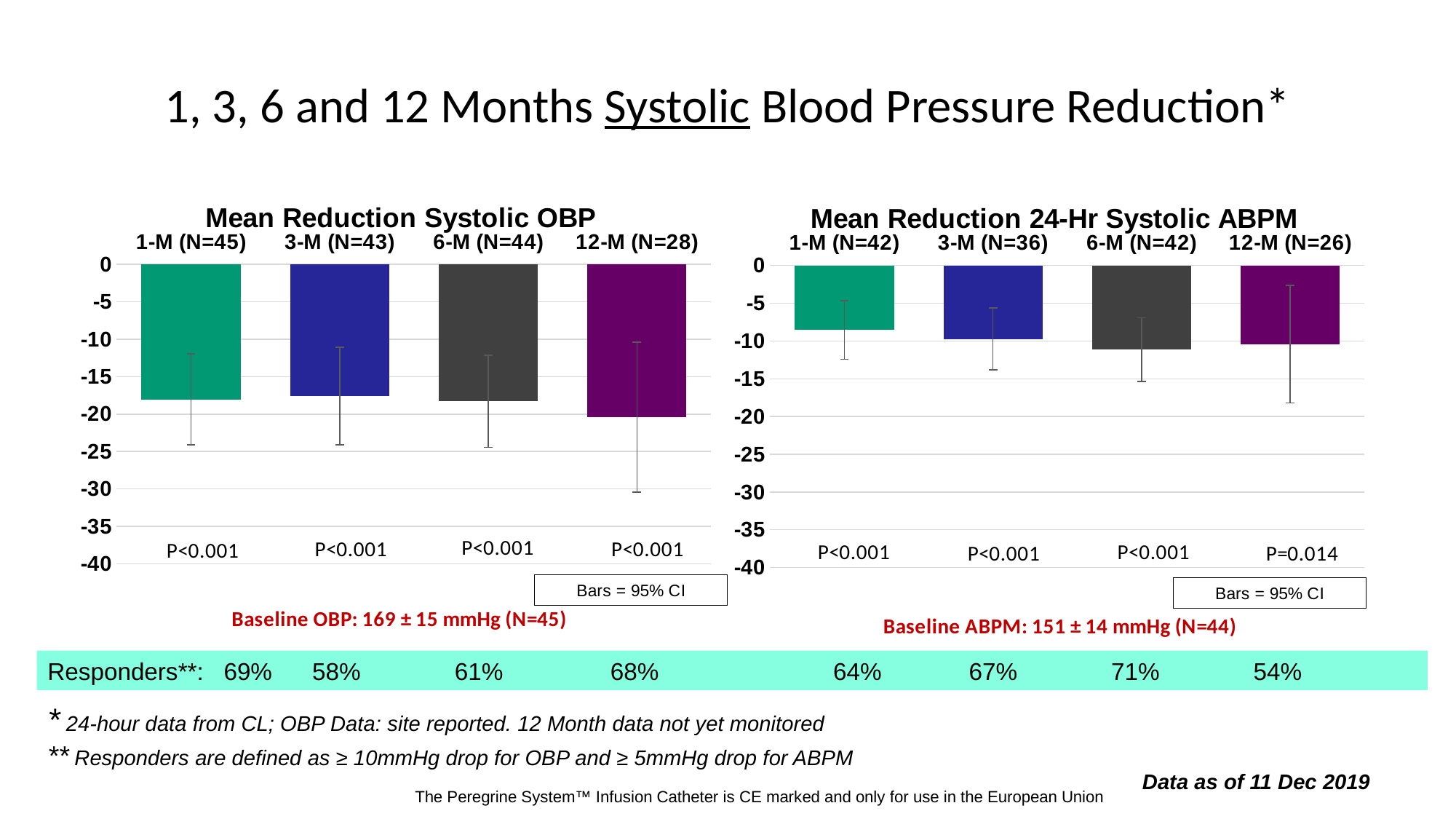
In the Mean Reduction 24-Hr Systolic ABPM chart, which bar shows a larger reduction: 1-M (N=42) or 6-M (N=42)? 6-M (N=42) What kind of chart is the Mean Reduction Systolic OBP chart? bar chart In the Mean Reduction 24-Hr Systolic ABPM chart, what P-value is shown for 12-M (N=26)? P=0.014 What is the title of the chart on the right side of the slide? Mean Reduction 24-Hr Systolic ABPM In the Mean Reduction Systolic OBP chart, which time point shows the largest reduction? 12-M (N=28) How many bars are shown in the Mean Reduction 24-Hr Systolic ABPM chart? 4 In the Mean Reduction 24-Hr Systolic ABPM chart, which time point shows the smallest reduction? 1-M (N=42) In the Mean Reduction 24-Hr Systolic ABPM chart, is the value for 1-M (N=42) greater or less than -10? greater What is the N shown for the 3-M bar in the Mean Reduction Systolic OBP chart? 43 In the Mean Reduction Systolic OBP chart, is the value for 1-M (N=45) greater or less than -15? less In the Mean Reduction Systolic OBP chart, which bar shows a larger reduction: 1-M (N=45) or 12-M (N=28)? 12-M (N=28) In the Mean Reduction 24-Hr Systolic ABPM chart, is the value for 1-M (N=42) greater or less than -5? less